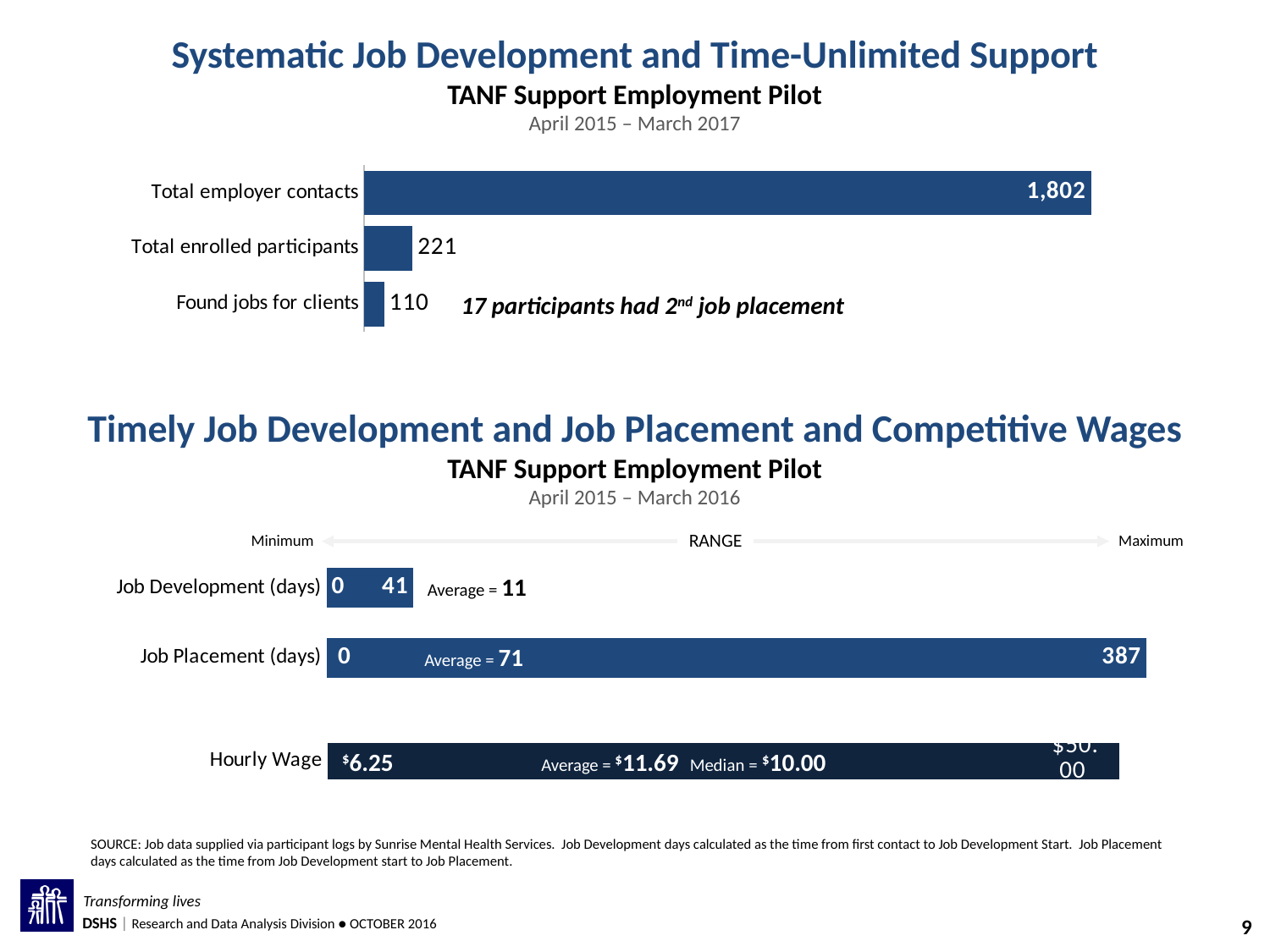
In the top chart (Systematic Job Development and Time-Unlimited Support), what is the value for Total employer contacts? 1,802 In the top chart (Systematic Job Development and Time-Unlimited Support), how many categories are plotted? 3 In the bottom chart (Timely Job Development and Job Placement and Competitive Wages), what is the minimum Hourly Wage? $6.25 In the top chart (Systematic Job Development and Time-Unlimited Support), what is the difference between Total enrolled participants and Found jobs for clients? 111 In the bottom chart (Timely Job Development and Job Placement and Competitive Wages), what is the average for Job Development (days)? 11 In the bottom chart (Timely Job Development and Job Placement and Competitive Wages), which has the larger average: Job Development (days) or Job Placement (days)? Job Placement (days) In the bottom chart (Timely Job Development and Job Placement and Competitive Wages), what is the median Hourly Wage? $10.00 In the top chart (Systematic Job Development and Time-Unlimited Support), what is the value for Total enrolled participants? 221 What kind of chart is the top chart (Systematic Job Development and Time-Unlimited Support)? Bar chart In the top chart (Systematic Job Development and Time-Unlimited Support), which category has the lowest value? Found jobs for clients In the bottom chart (Timely Job Development and Job Placement and Competitive Wages), what is the maximum value for Job Placement (days)? 387 In the top chart (Systematic Job Development and Time-Unlimited Support), what is the value for Found jobs for clients? 110